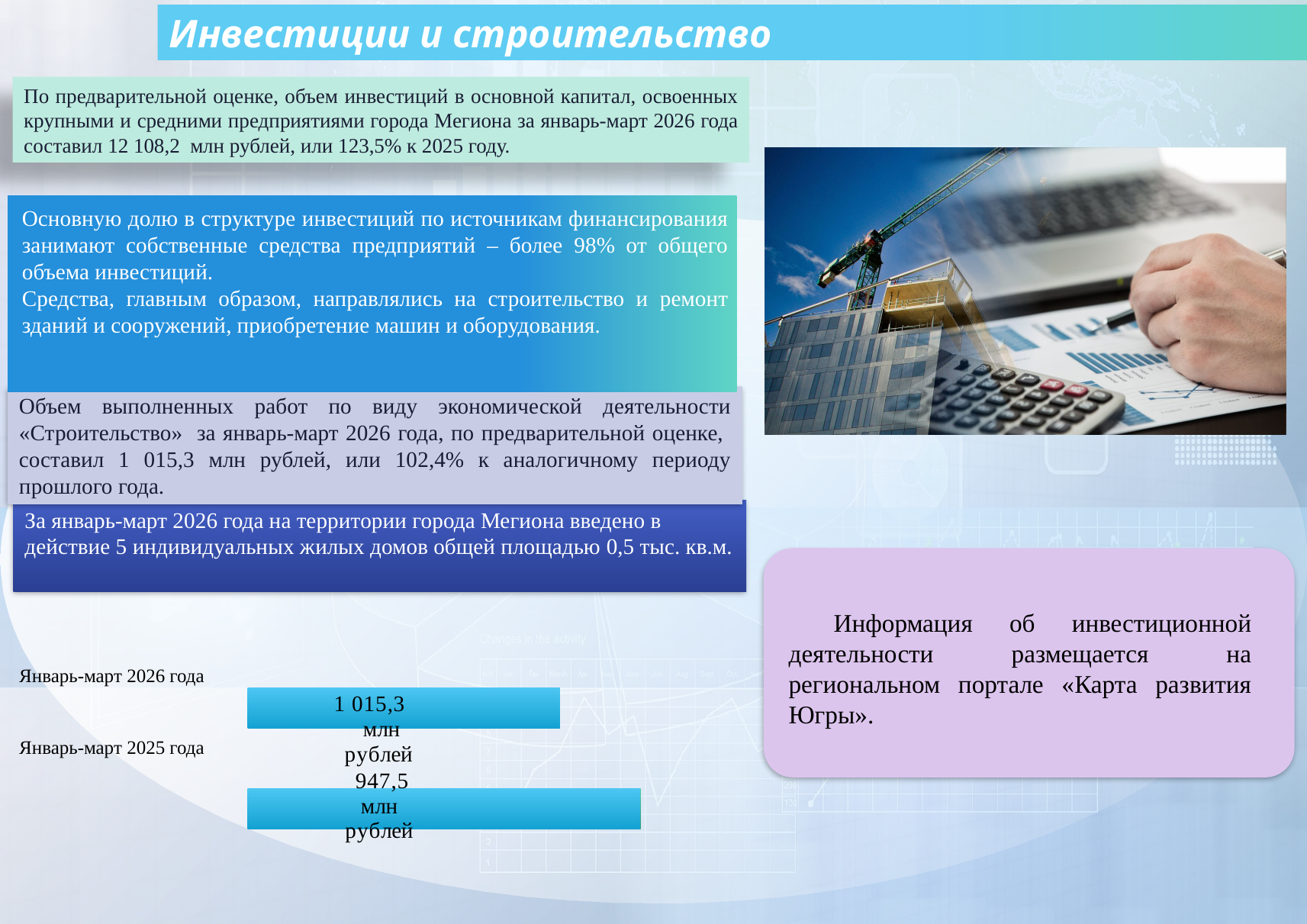
Which category has the highest value according to the data labels in the bar chart? Январь-март 2026 года What value is shown for Январь-март 2026 года in the bar chart? 1 015,3 млн рублей How many categories does the bar chart show? 2 According to the data labels, which period has the higher value: Январь-март 2026 года or Январь-март 2025 года? Январь-март 2026 года What kind of chart is shown at the bottom left of the slide? bar chart What colour are the bars in the chart? blue What are the two category labels on the bar chart? Январь-март 2026 года and Январь-март 2025 года What value is shown for Январь-март 2025 года in the bar chart? 947,5 млн рублей Which category has the lowest value according to the data labels in the bar chart? Январь-март 2025 года According to the data labels, what is the difference between the values for Январь-март 2026 года and Январь-март 2025 года? 67,8 млн рублей